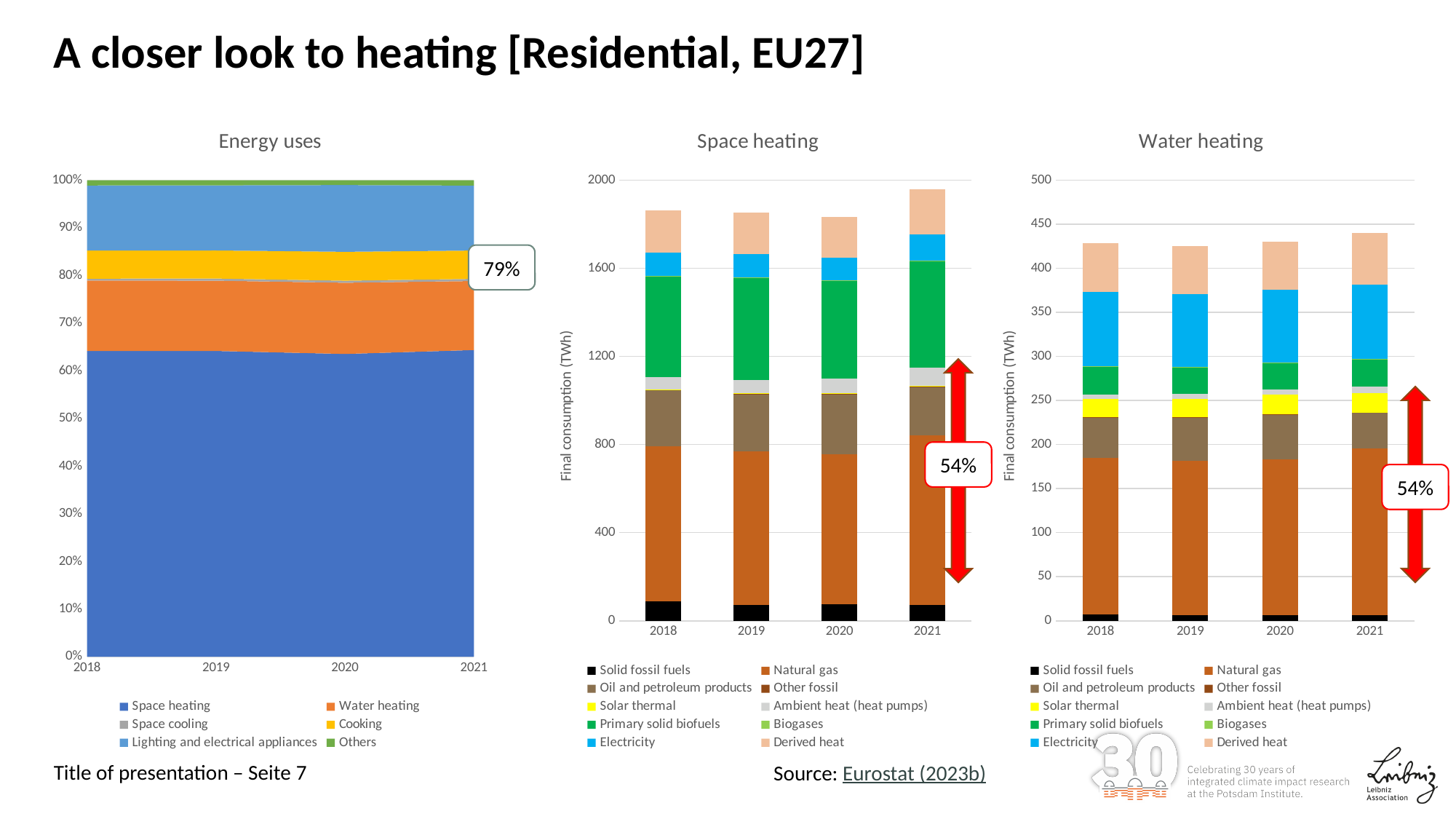
In the Energy uses chart, which series occupies the largest share in 2021? Space heating In the Energy uses chart, what kind of chart is it? Stacked area chart In the Water heating chart, is the total final consumption in 2018 greater or less than 450 TWh? less In the Energy uses chart, what percentage is shown in the callout box next to the 2021 values? 79% In the Space heating chart, which year has the highest total final consumption? 2021 In the Space heating chart, is the total final consumption in 2021 greater or less than 1800 TWh? greater In the Energy uses chart, how many series does the legend list? 6 In the Space heating chart, how many years are shown on the x axis? 4 How many charts are shown on the slide? 3 In the Energy uses chart, is the share of Space heating in 2018 greater or less than 60%? greater In the Space heating chart, what kind of chart is it? Stacked bar chart In the Water heating chart, how many series does the legend list? 10